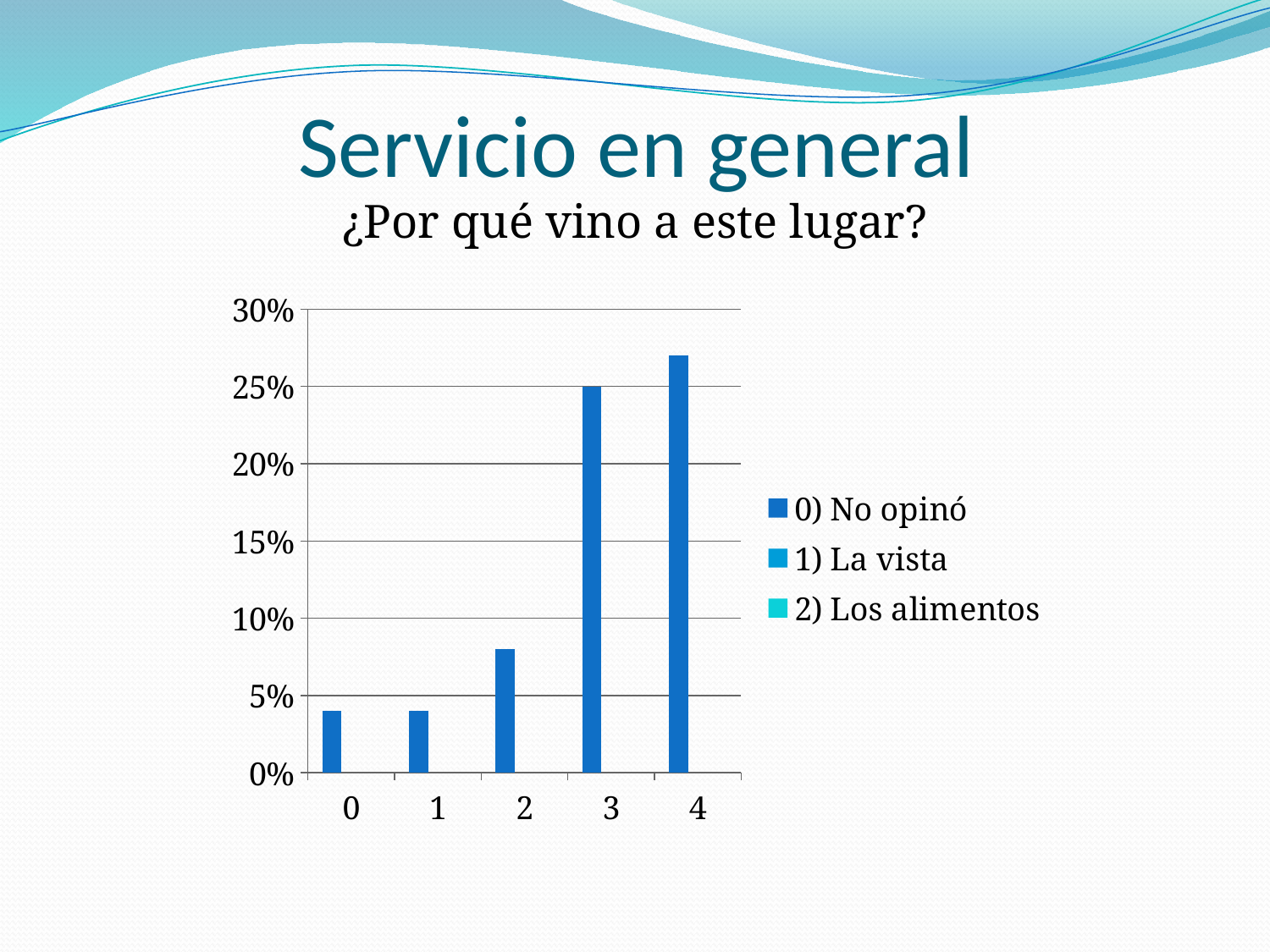
Is the value for category 2 greater or less than 5%? greater How many categories are shown on the x axis of the chart? 5 Which category has the highest value? 4 Which has the larger value, category 2 or category 3? 3 How many entries does the chart's legend list? 3 Do the values generally rise or fall from category 0 to category 4? rise Is the value for category 0 greater or less than 5%? less What is the value for category 3? 25% Is the value for category 4 greater or less than 25%? greater What is the second legend entry of the chart? 1) La vista What kind of chart is shown on the slide? bar chart